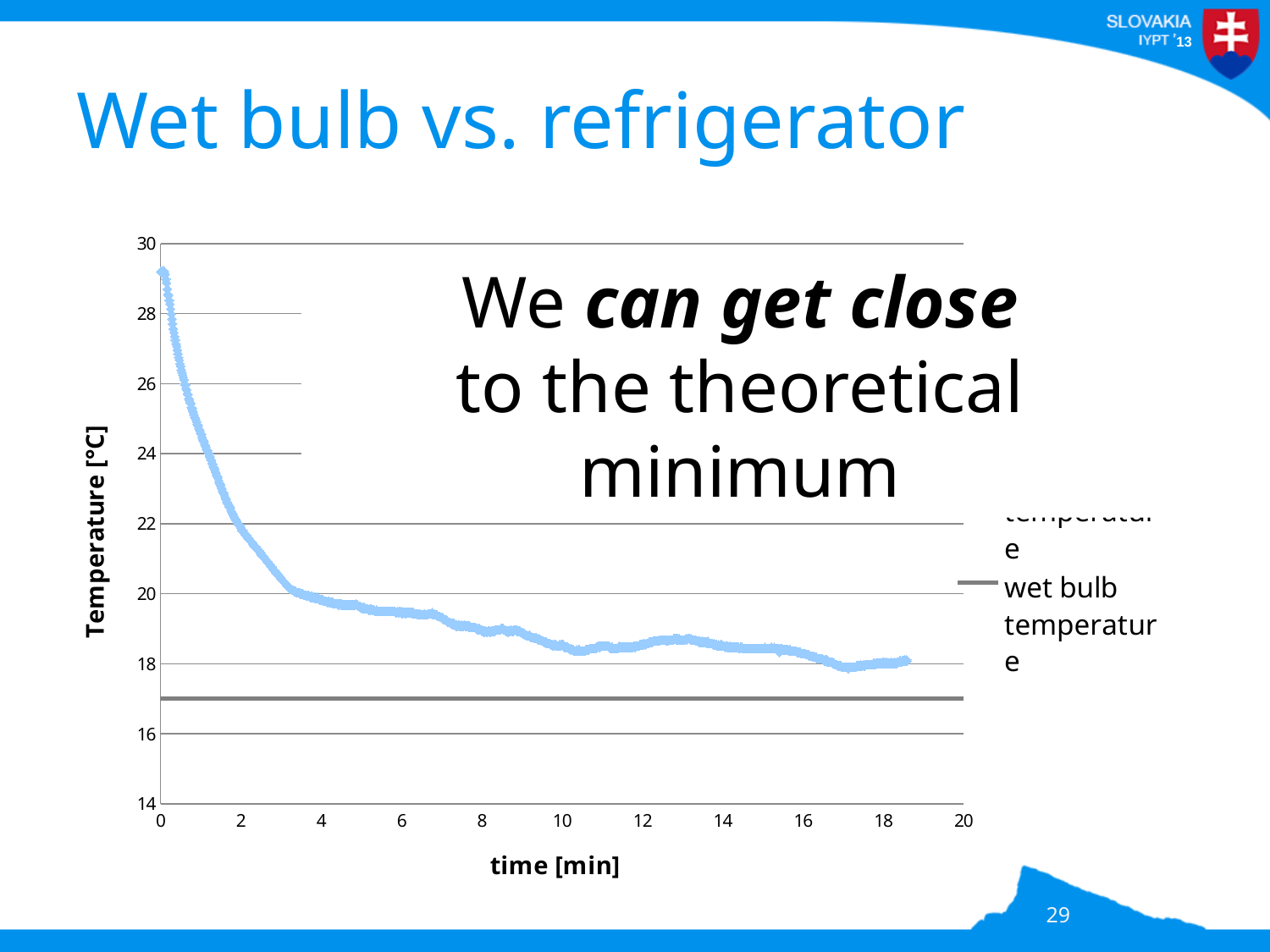
What kind of chart is shown on the slide? line chart Is the wet bulb temperature line greater or less than 16? greater What is the highest tick value shown on the y axis? 30 Does the blue temperature series rise or fall as time increases? fall What is the label of the y axis? Temperature [°C] At time 10, which is higher: the blue temperature series or the wet bulb temperature line? the blue temperature series Is the blue temperature series at time 18 greater or less than 20? less What is the label of the x axis? time [min] Is the blue temperature series at time 4 greater or less than 22? less How many series does the legend list? 2